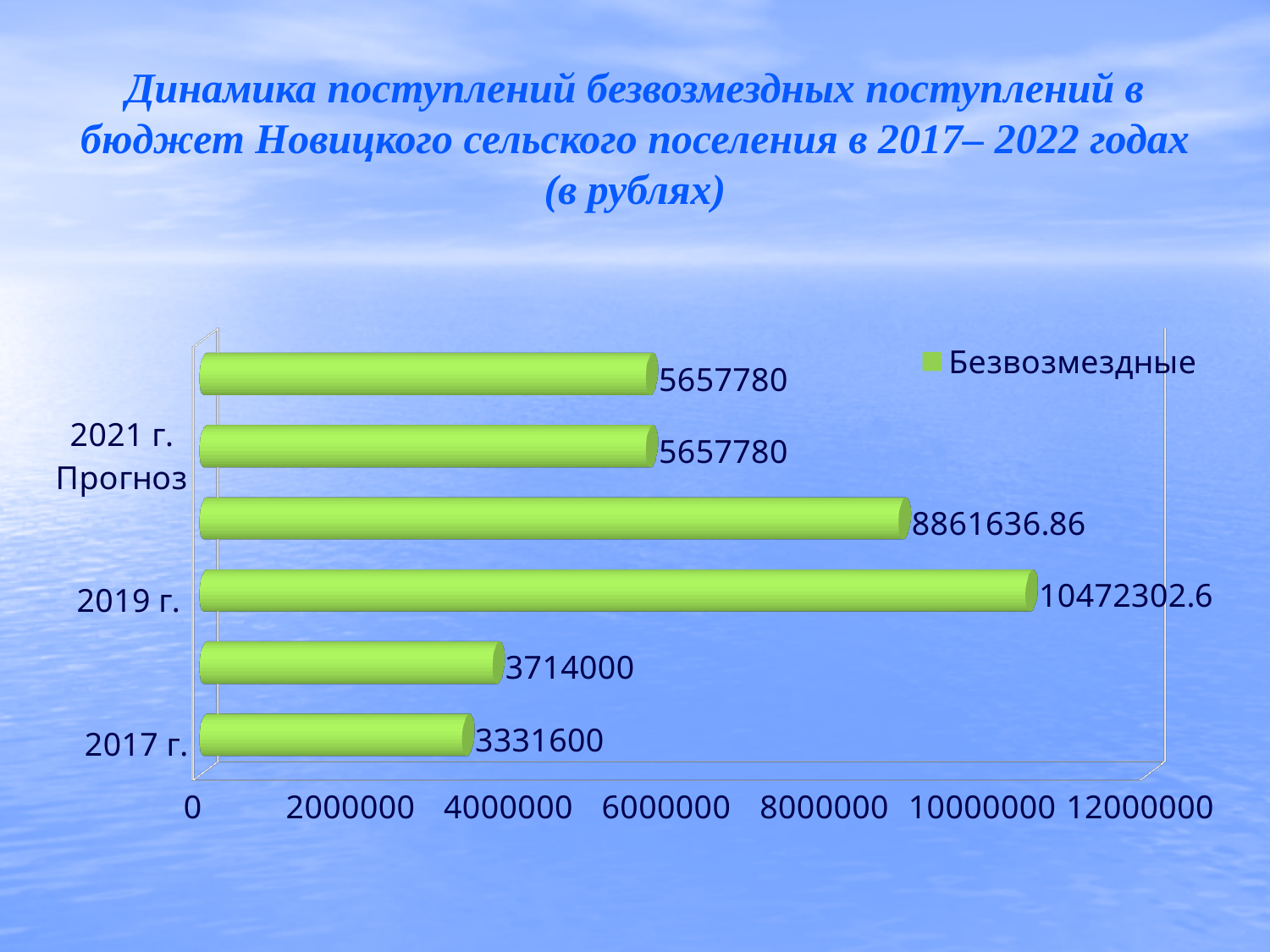
What kind of chart is shown on the slide? bar chart What is the difference between the values for 2019 г. and 2017 г.? 7140702.6 Is the value for 2019 г. greater or less than 10000000? greater Which is larger, the value for 2017 г. or for 2021 г. Прогноз? 2021 г. Прогноз How many series does the legend list? 1 Which bar has the lowest value on the chart? 2017 г. What is the value of the bar for 2017 г.? 3331600 What is the difference between the values for 2021 г. Прогноз and 2017 г.? 2326180 Which labelled year has the highest value? 2019 г. How many bars are plotted on the chart? 6 What is the value of the bar for 2021 г. Прогноз? 5657780 What is the value of the bar for 2019 г.? 10472302.6